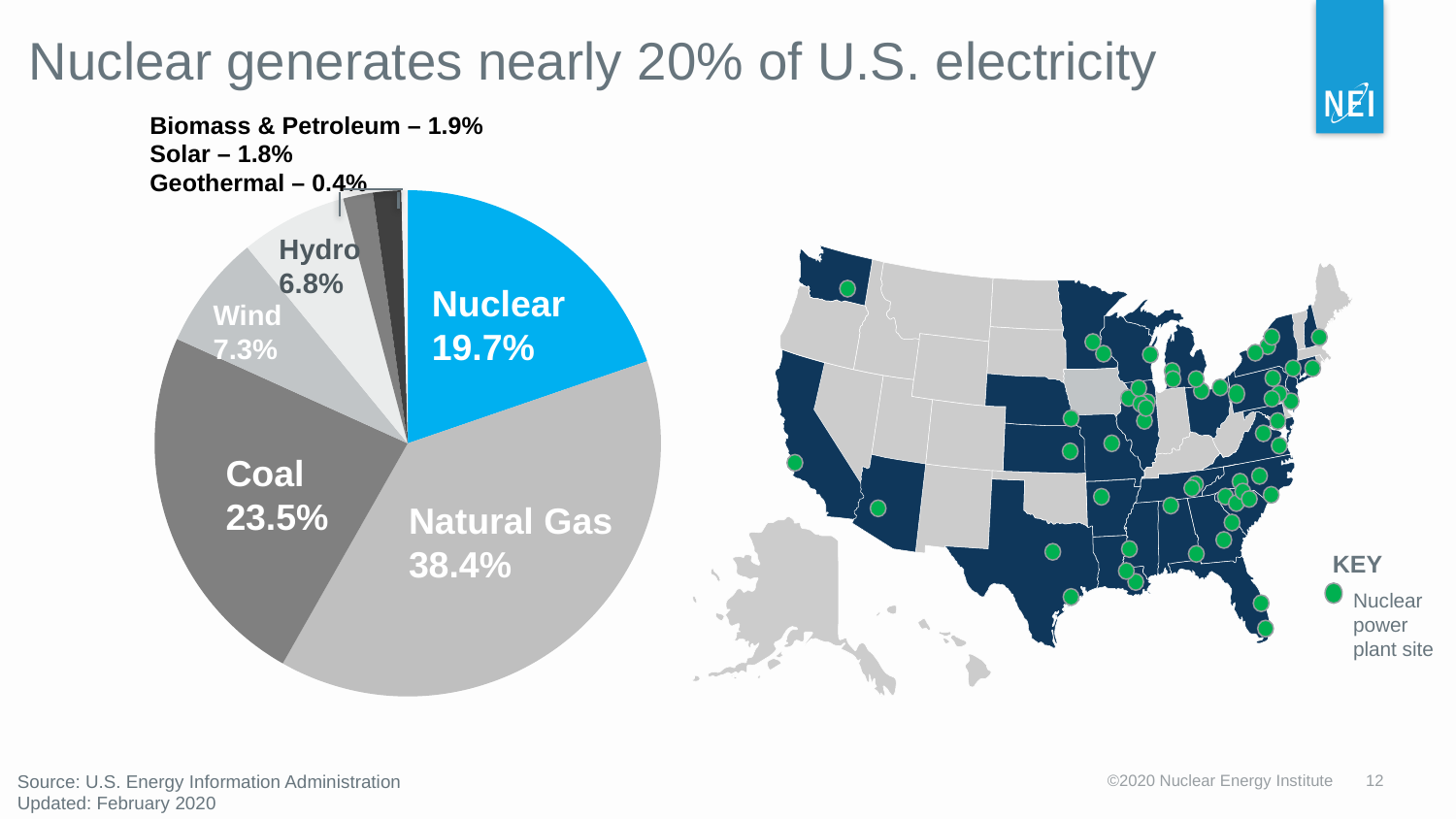
Which energy source has the smallest slice of the pie chart? Geothermal What is the difference in percentage points between Natural Gas and Coal in the pie chart? 14.9 What percentage does the pie chart show for Wind? 7.3% What colour is the Nuclear slice in the pie chart? Blue What share of U.S. electricity does Nuclear generate according to the pie chart? 19.7% What type of chart is used to show the U.S. electricity generation mix? Pie chart Which energy source has the largest slice of the pie chart? Natural Gas How many energy sources are shown in the pie chart? 8 What percentage of the pie chart is Natural Gas? 38.4% What is the value for Geothermal in the pie chart? 0.4% Which is larger in the pie chart, Wind or Hydro? Wind What is the value shown for Coal in the pie chart? 23.5%